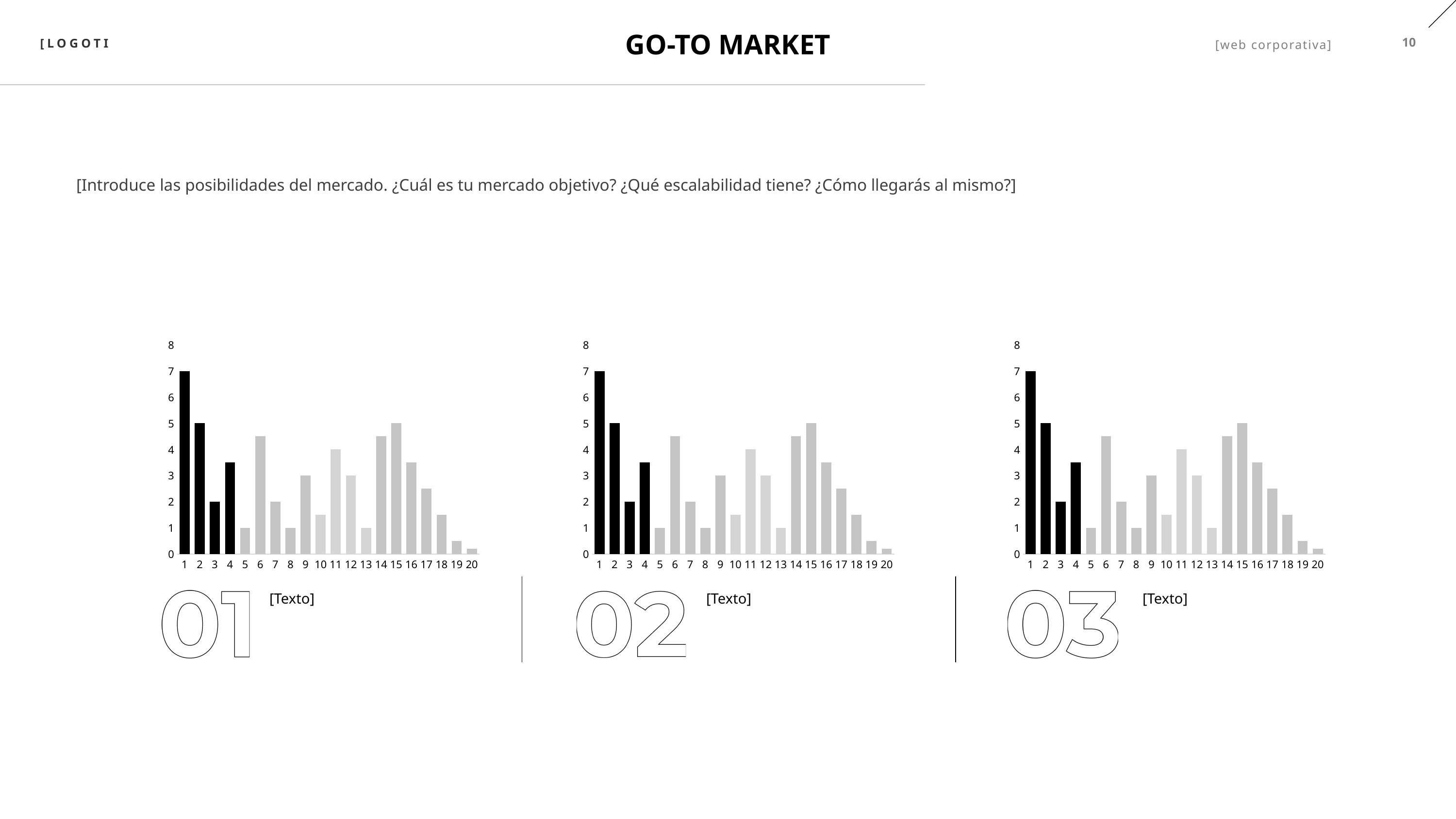
What kind of chart is the left chart on the slide? bar chart In the right chart, what is the difference between the values for category 1 and category 3? 5 How many bar charts are shown on the slide? 3 In the middle chart, which is larger, the value for category 9 or the value for category 13? category 9 In the right chart, what is the value for category 2? 5 In the left chart, how many categories are shown on the x axis? 20 In the right chart, is the value for category 18 greater or less than 2? less In the middle chart, what is the value for category 1? 7 In the left chart, is the value for category 6 greater or less than 4? greater In the left chart, which category has the highest bar? 1 In the left chart, what is the value for category 11? 4 In the middle chart, which category has the lowest bar? 20